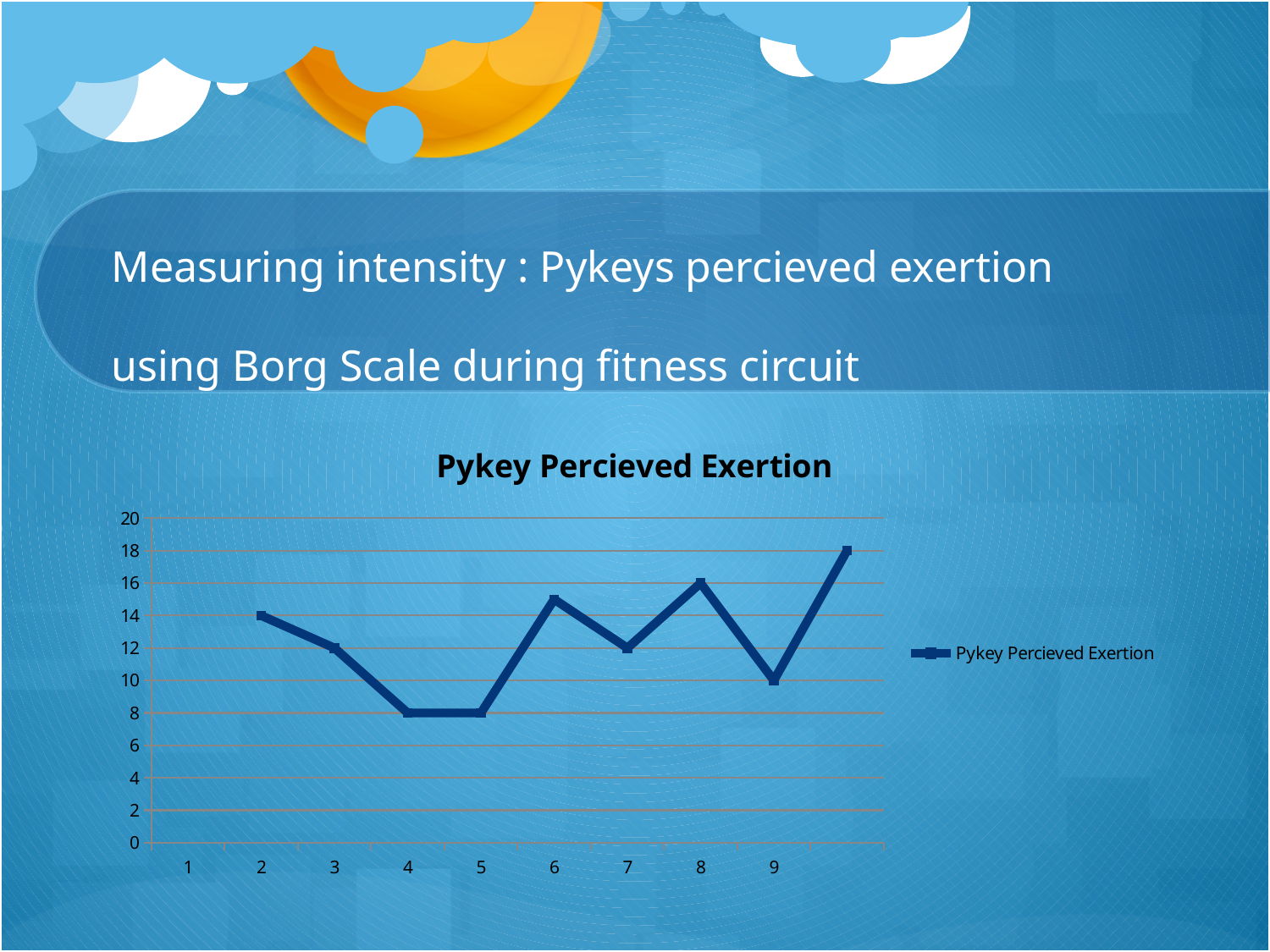
What is the Pykey Percieved Exertion value at category 9? 10 What is the Pykey Percieved Exertion value at category 4? 8 Which has the larger value, category 8 or category 9? category 8 What type of chart is shown on the slide? line chart Is the value at category 6 greater or less than 14? greater What is the difference between the values at category 8 and category 2? 2 What is the Pykey Percieved Exertion value at category 7? 12 What is the title of the chart? Pykey Percieved Exertion What is the Pykey Percieved Exertion value at category 8? 16 How many series does the legend list? 1 What is the Pykey Percieved Exertion value at category 2? 14 Does the line rise or fall from category 3 to category 4? fall